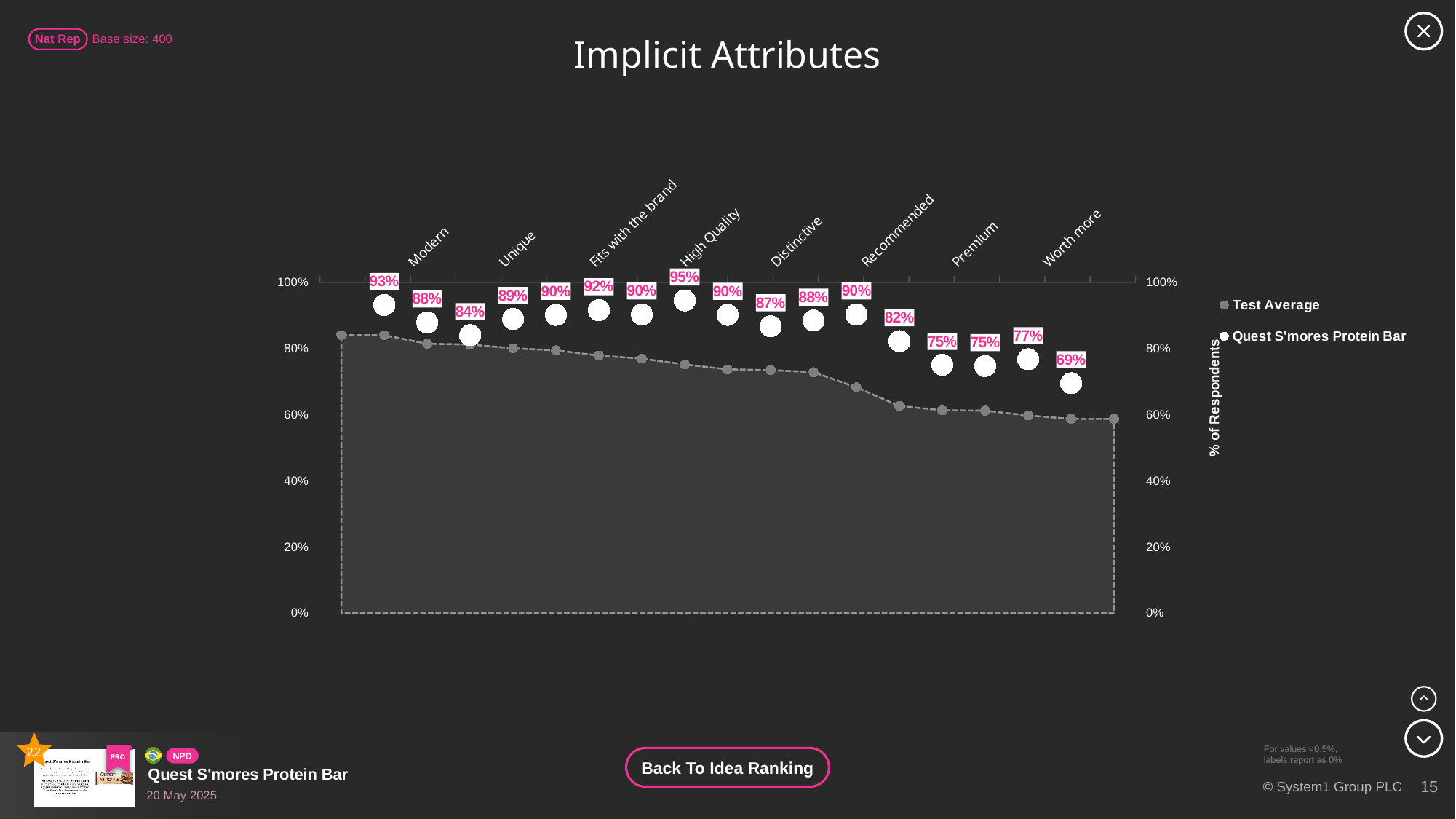
What is the lowest value labeled for the Quest S'mores Protein Bar series? 69% How many labeled data points does the Quest S'mores Protein Bar series have? 17 What is the highest value labeled for the Quest S'mores Protein Bar series? 95% Is the Test Average value at the leftmost point greater or less than 80%? greater Do the Quest S'mores Protein Bar values generally rise or fall from left to right? Fall How many attribute labels are shown along the top of the chart? 8 What are the two series named in the legend? Test Average and Quest S'mores Protein Bar How many series does the legend list? 2 What is the difference between the highest and lowest labeled values for Quest S'mores Protein Bar? 26 percentage points What kind of chart is shown on the slide? Combination area and line chart What is the title of the chart? Implicit Attributes Is the Quest S'mores Protein Bar series above or below the Test Average line across the chart? Above